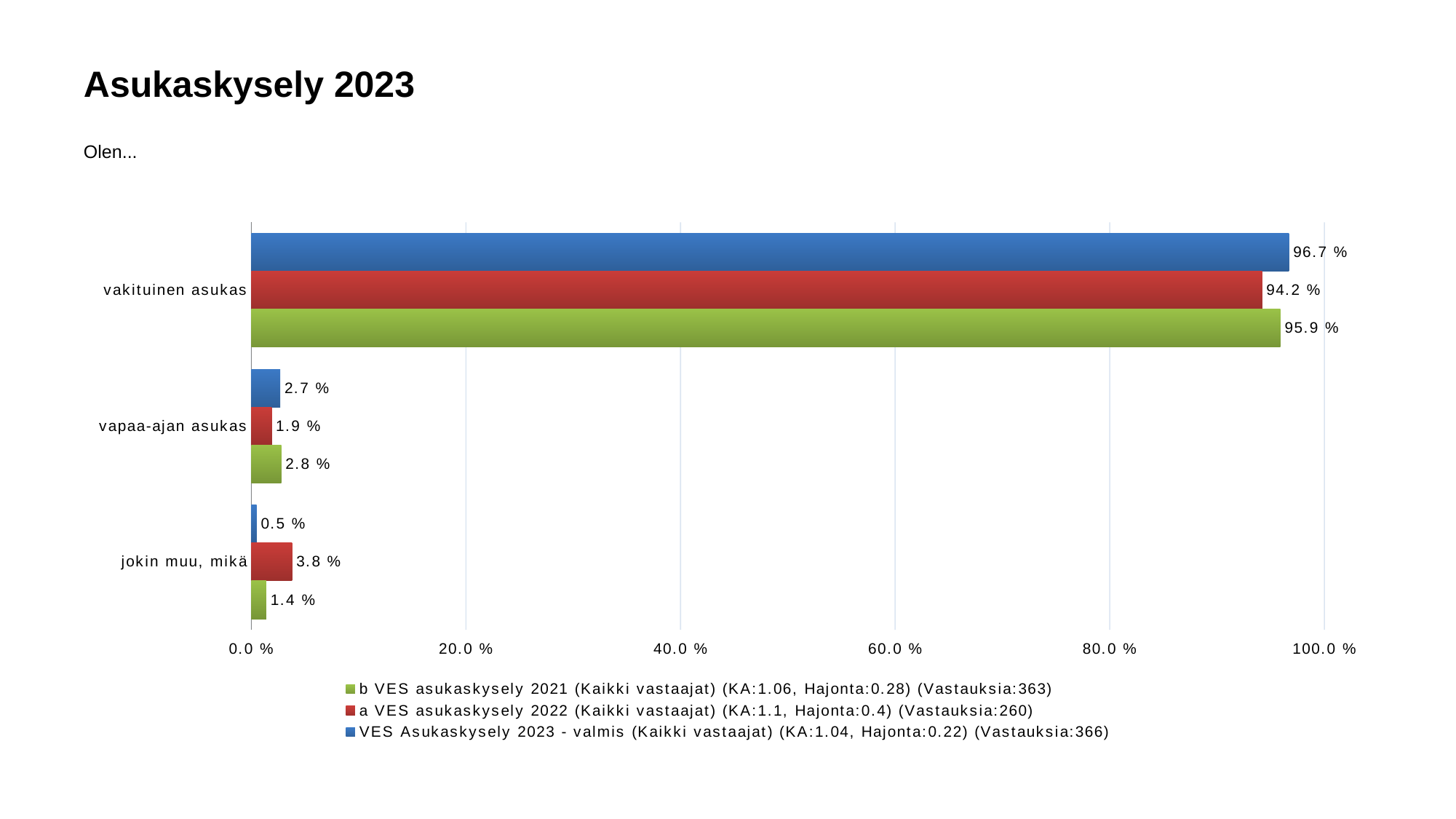
What is the difference between the 2022 and 2023 values for "jokin muu, mikä"? 3.3 % What kind of chart is shown on the slide? bar chart Which category has the highest value in the VES Asukaskysely 2023 series? vakituinen asukas Is the value for "vakituinen asukas" in the 2022 series greater or less than 80.0 %? greater What is the value for "vapaa-ajan asukas" in the VES asukaskysely 2021 series? 2.8 % For "vakituinen asukas", which series has the larger value: VES asukaskysely 2021 or VES asukaskysely 2022? VES asukaskysely 2021 What is the difference between the 2023 and 2022 values for "vakituinen asukas"? 2.5 % Which category has the lowest value in the VES Asukaskysely 2023 series? jokin muu, mikä How many categories are shown on the chart? 3 How many series does the legend list? 3 What is the value for "jokin muu, mikä" in the VES asukaskysely 2022 series? 3.8 % What is the value for "vakituinen asukas" in the VES Asukaskysely 2023 series? 96.7 %